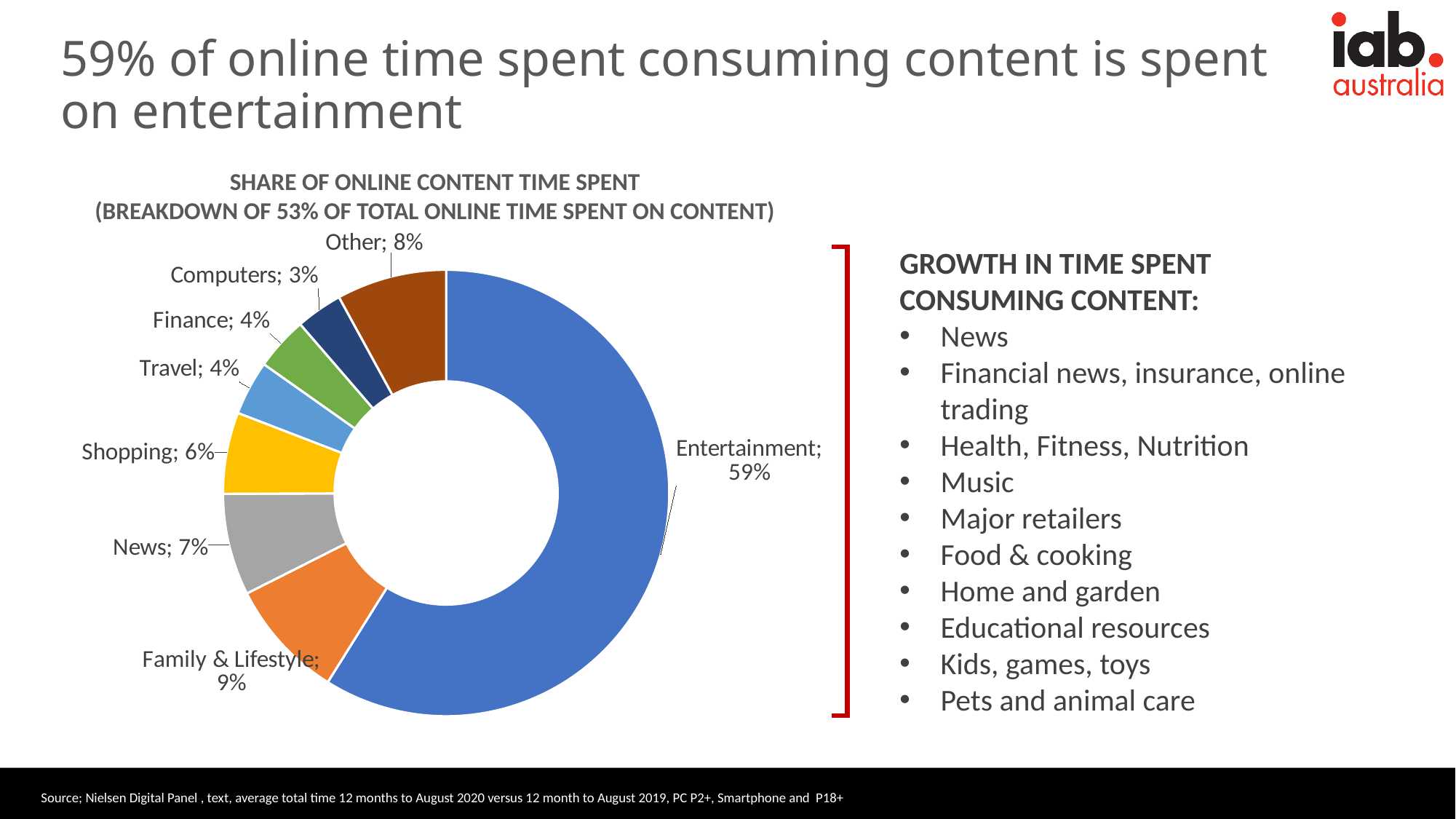
How many categories are shown in the chart? 8 What is the title of the chart? SHARE OF ONLINE CONTENT TIME SPENT (BREAKDOWN OF 53% OF TOTAL ONLINE TIME SPENT ON CONTENT) What share of online content time spent is Entertainment? 59% What share of online content time spent is Other? 8% Which category has the smallest share of online content time spent? Computers What is the difference in share between Entertainment and Family & Lifestyle? 50 percentage points Which has a larger share, News or Shopping? News What share of online content time spent is Family & Lifestyle? 9% What is the combined share of Travel and Finance? 8% What kind of chart is shown on the slide? Doughnut (pie) chart What share of online content time spent is Shopping? 6% Which category has the largest share of online content time spent? Entertainment